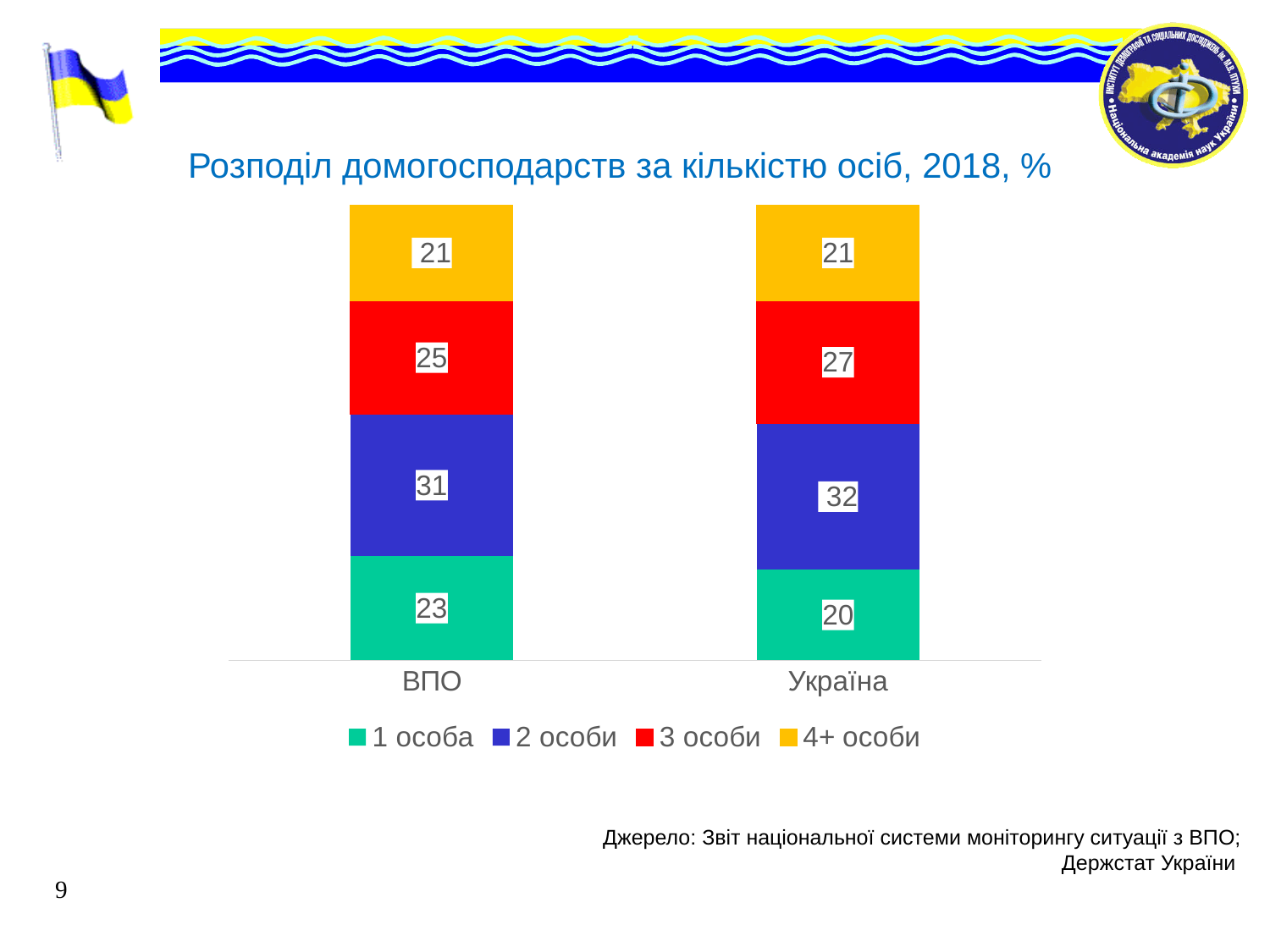
Which is larger: the "1 особа" value for ВПО or for Україна? ВПО How many series does the legend list? 4 What is the difference between the "3 особи" values for Україна and ВПО? 2 What is the value for "3 особи" in the ВПО bar? 25 What kind of chart is shown on the slide? Stacked bar chart What is the value for "4+ особи" in the Україна bar? 21 Which series has the largest value in the ВПО bar? 2 особи How many categories are shown on the x axis? 2 What is the value for "2 особи" in the Україна bar? 32 What is the total of the stacked bar for ВПО? 100 Which series has the smallest value in the Україна bar? 1 особа What is the value for "1 особа" in the ВПО bar? 23